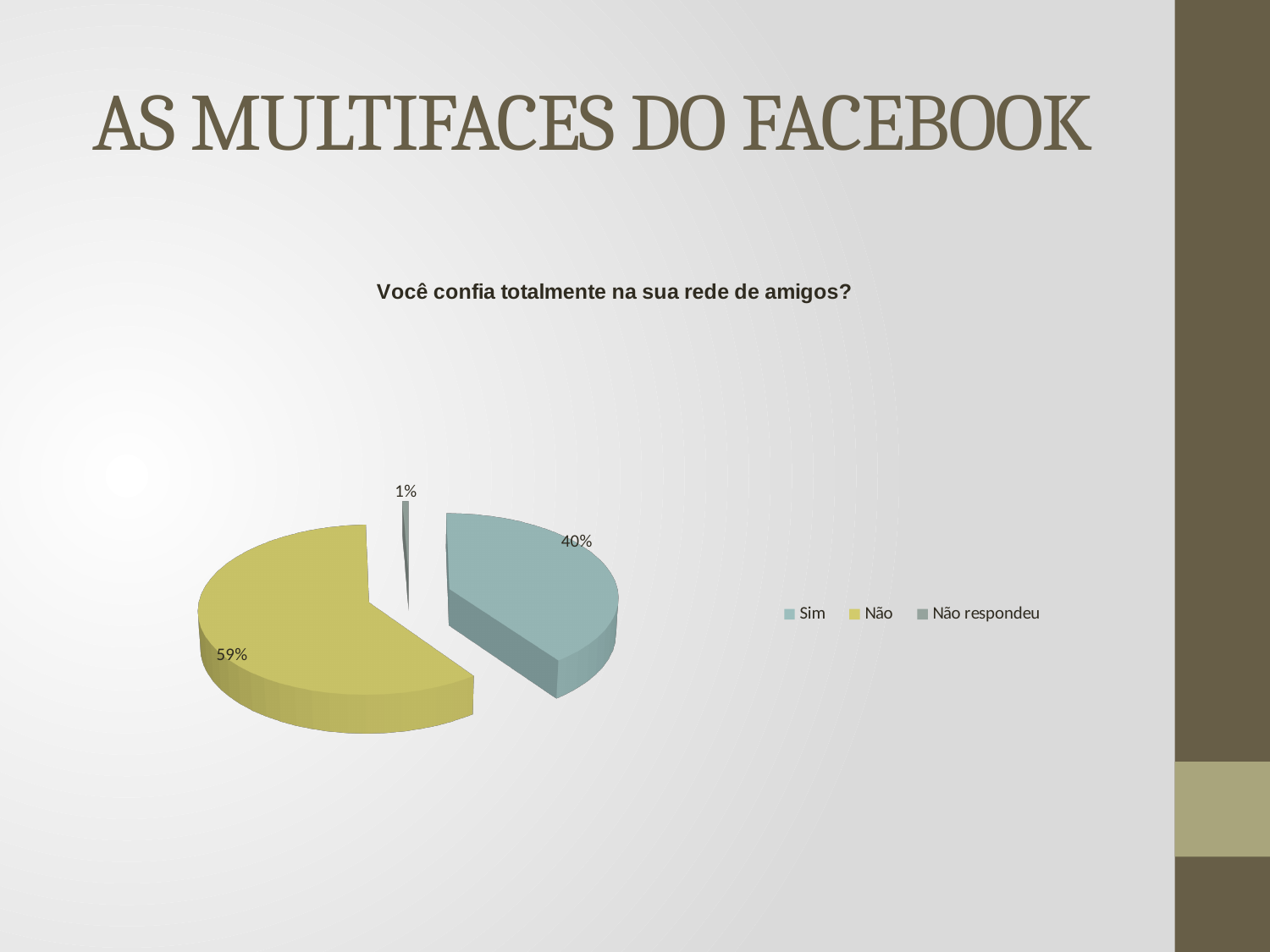
Which category has the smallest share of the pie? Não respondeu Which category has the largest share of the pie? Não Which colour represents "Sim" in the chart? blue-grey What is the title of the chart? Você confia totalmente na sua rede de amigos? What percentage of respondents answered "Sim"? 40% What kind of chart is shown on the slide? pie chart What percentage of respondents answered "Não"? 59% How many slices does the pie chart have? 3 How many categories does the legend list? 3 Which is larger, the share for "Sim" or the share for "Não"? Não What percentage is shown for "Não respondeu"? 1% What is the difference in percentage points between "Não" and "Sim"? 19